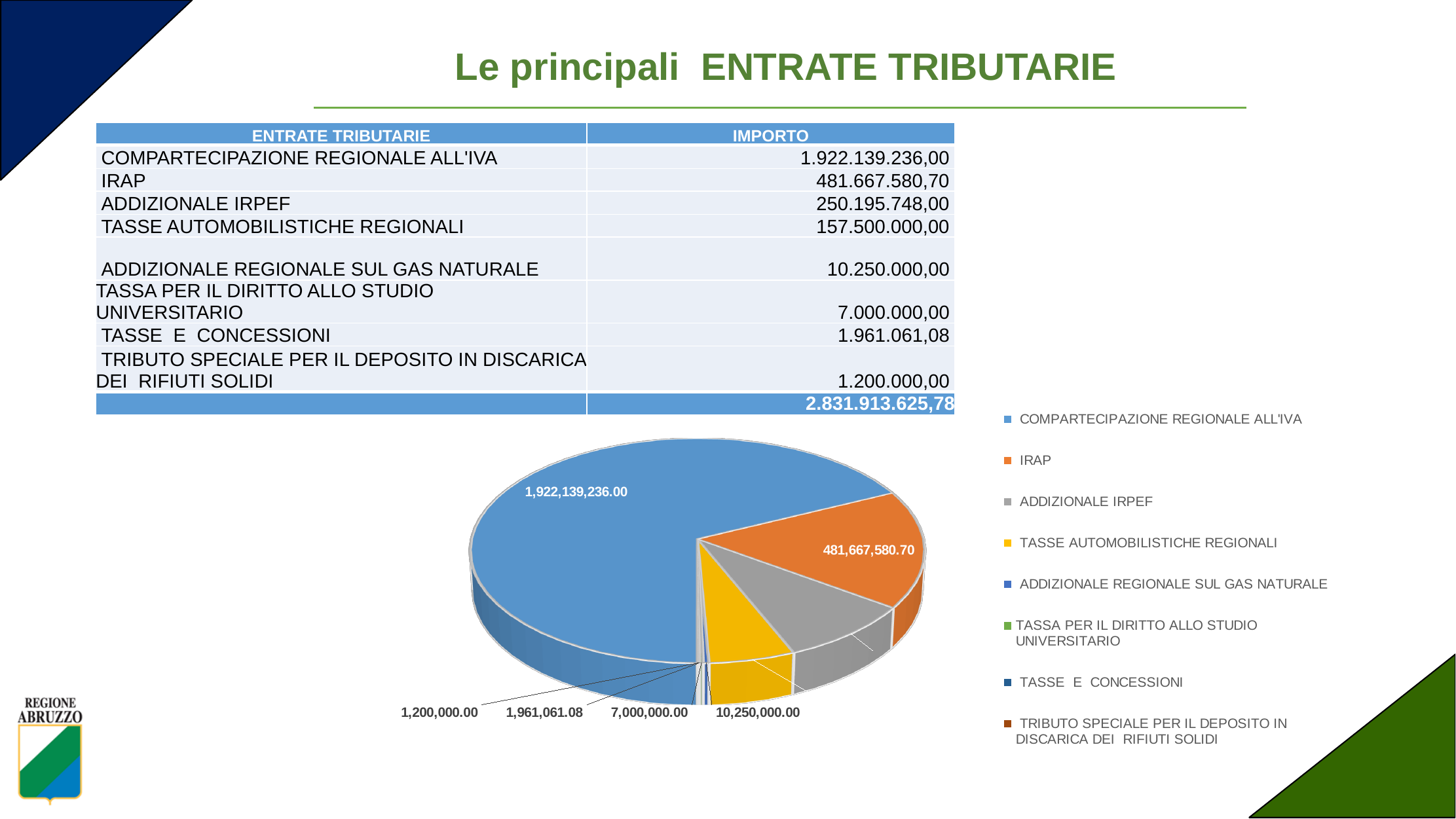
In the pie chart, which slice is larger: IRAP or ADDIZIONALE IRPEF? IRAP What kind of chart is shown on the slide? pie chart What is the difference between the labelled values for ADDIZIONALE REGIONALE SUL GAS NATURALE and TASSA PER IL DIRITTO ALLO STUDIO UNIVERSITARIO in the pie chart? 3,250,000.00 How many entries does the pie chart's legend list? 8 What colour is the IRAP slice in the pie chart? orange What value is labelled on the pie slice for ADDIZIONALE REGIONALE SUL GAS NATURALE? 10,250,000.00 What value is labelled on the pie slice for COMPARTECIPAZIONE REGIONALE ALL'IVA? 1,922,139,236.00 What value is labelled on the pie slice for IRAP? 481,667,580.70 Which category has the smallest slice in the pie chart? TRIBUTO SPECIALE PER IL DEPOSITO IN DISCARICA DEI RIFIUTI SOLIDI Which category has the largest slice in the pie chart? COMPARTECIPAZIONE REGIONALE ALL'IVA What value is labelled on the pie slice for TASSE E CONCESSIONI? 1,961,061.08 What is the difference between the labelled values for COMPARTECIPAZIONE REGIONALE ALL'IVA and IRAP in the pie chart? 1,440,471,655.30